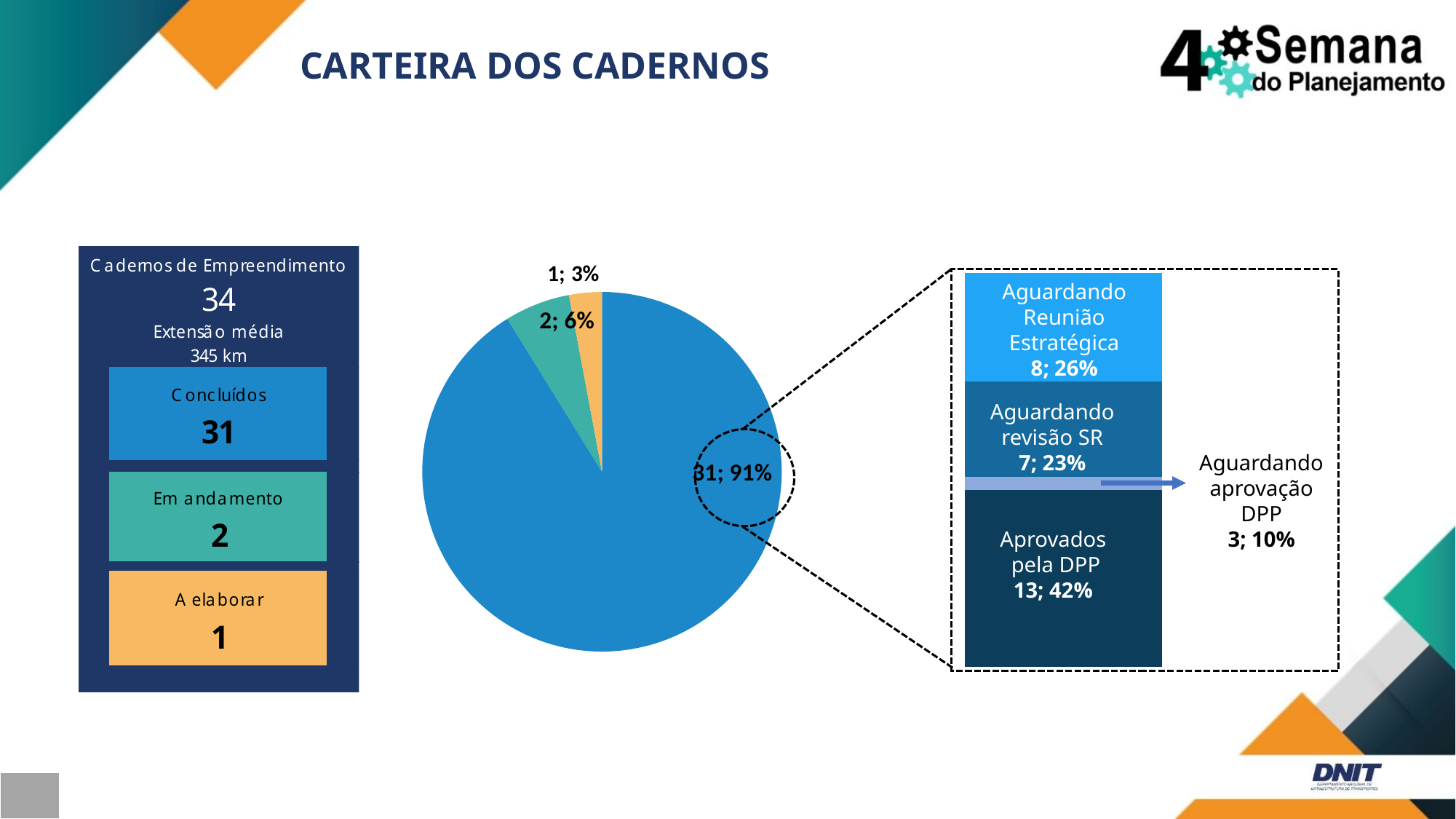
In the stacked bar on the right, what value and share are shown for Aguardando revisão SR? 7; 23% In the pie chart, what value and share are shown for the orange slice (A elaborar)? 1; 3% What kind of chart is the large chart in the centre of the slide? pie chart In the pie chart, what value and share are shown for the teal slice (Em andamento)? 2; 6% In the pie chart, what is the difference between the value of the blue slice and the teal slice? 29 How many slices does the pie chart have? 3 In the stacked bar on the right, which is larger: Aguardando Reunião Estratégica or Aguardando revisão SR? Aguardando Reunião Estratégica In the pie chart, what percentage share does the smallest slice have? 3% In the pie chart, what value and share are shown for the largest (blue) slice? 31; 91% In the stacked bar on the right, which segment has the lowest value? Aguardando aprovação DPP In the stacked bar on the right, which segment has the highest value? Aprovados pela DPP In the stacked bar on the right, what is the total of all four segments? 31